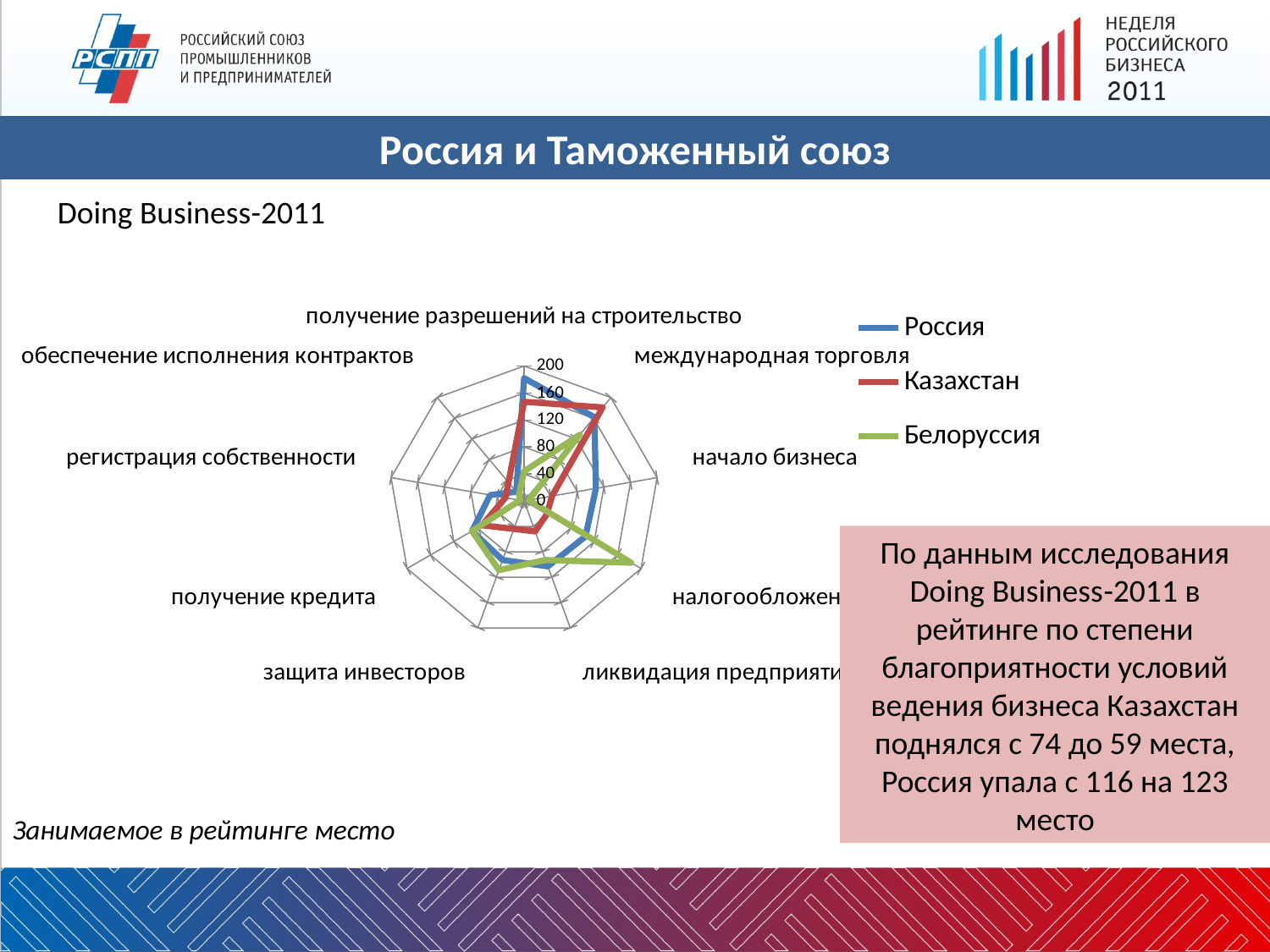
What is the highest value shown on the chart's axis scale? 200 Is the value for Россия on начало бизнеса greater or less than 160? less Is the value for Белоруссия on налогообложение greater or less than 120? greater Is the value for Россия on получение кредита greater or less than 120? less What kind of chart is shown on the slide? radar chart On налогообложение, which series has the larger value, Белоруссия or Россия? Белоруссия How many series does the chart legend list? 3 Which series is drawn in blue in the chart? Россия On получение разрешений на строительство, which series has the larger value, Россия or Белоруссия? Россия